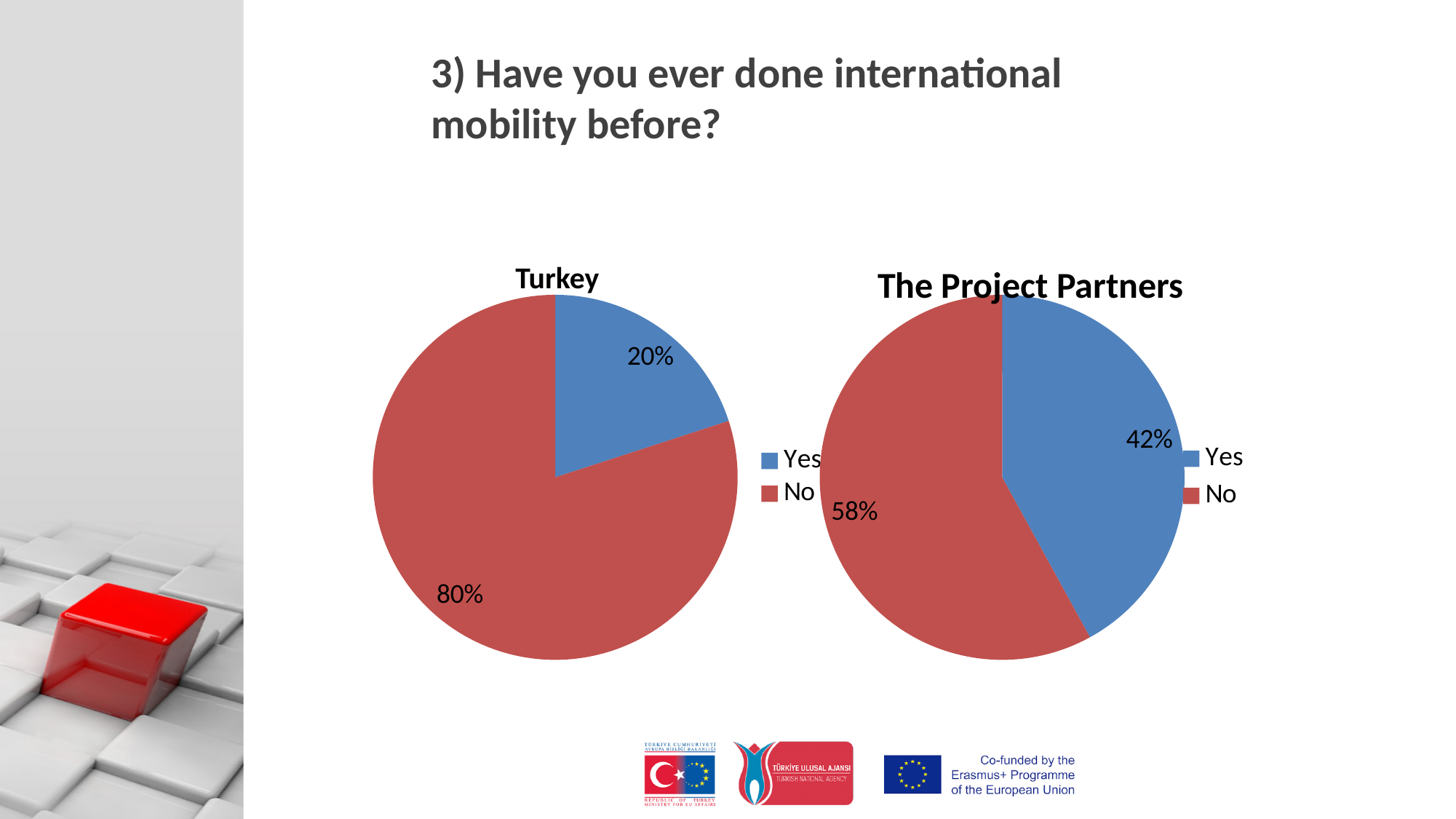
Which chart has the larger Yes share, Turkey or The Project Partners? The Project Partners In the Turkey chart, what is the difference between the No and Yes percentages? 60% In the Turkey chart, what percentage answered No? 80% What type of chart is the Turkey chart? Pie chart In the Turkey chart, which answer has the largest slice? No In The Project Partners chart, what percentage answered No? 58% In the Turkey chart, what percentage answered Yes? 20% In the Turkey chart, what colour is the No slice? Red In The Project Partners chart, which answer has the smallest slice? Yes In The Project Partners chart, what percentage answered Yes? 42% How many slices does The Project Partners chart have? 2 In The Project Partners chart, what is the difference between the No and Yes percentages? 16%